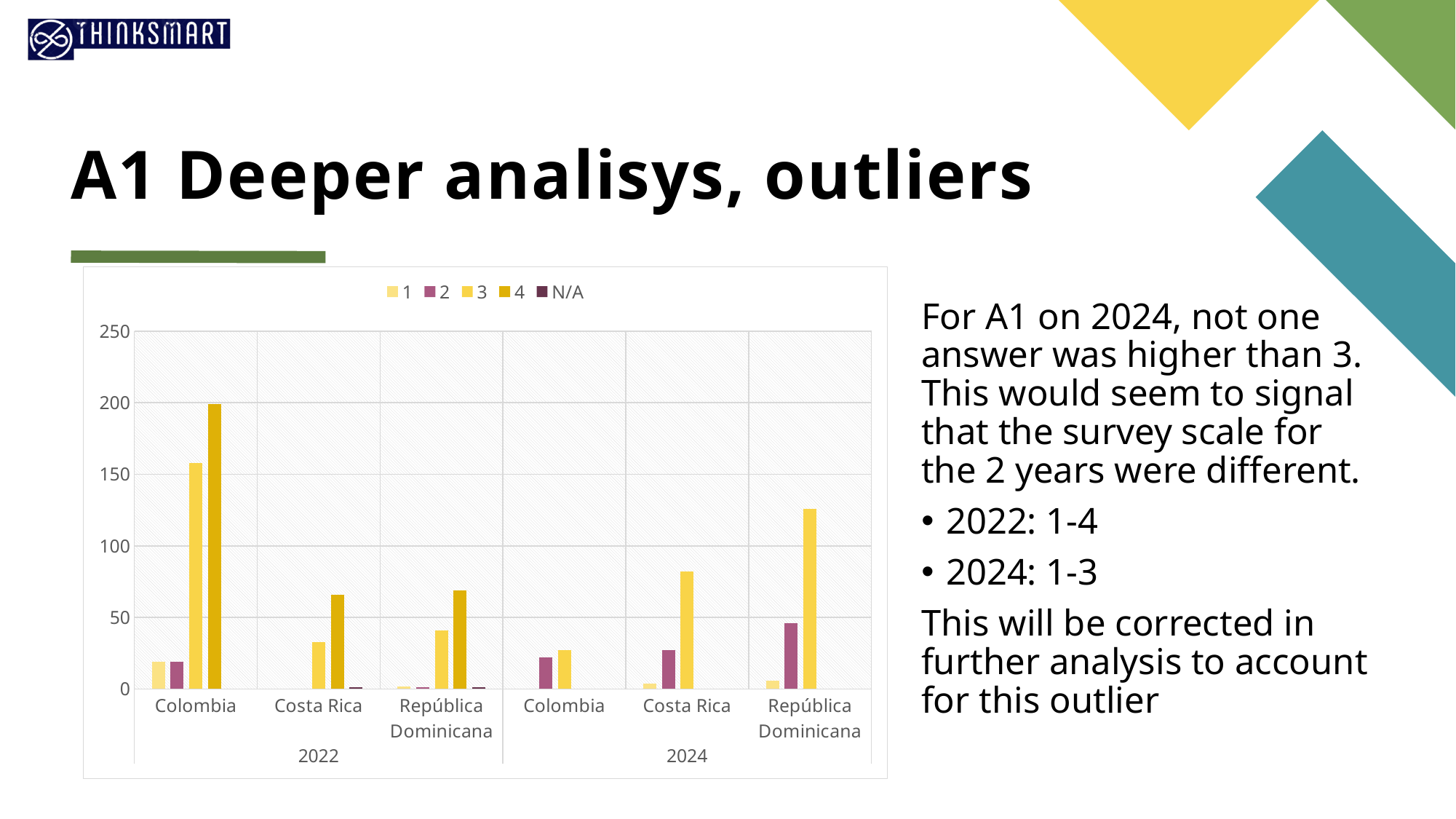
For Colombia in 2022, which is larger: the bar for series 3 or the bar for series 4? 4 Which years are shown on the x axis of the chart? 2022 and 2024 Which series has the tallest bar in the whole chart? 4 Is the value of series 3 for Colombia in 2022 greater or less than 100? greater How many series does the chart legend list? 5 Is the value of series 3 for República Dominicana in 2024 greater or less than 100? greater Is the value of series 4 for Colombia in 2022 greater or less than 150? greater For Colombia in 2022, which series has the tallest bar? 4 What kind of chart is shown on the slide? bar chart How many country categories are plotted under each year in the chart? 3 In 2024, which country has the tallest bar for series 3? República Dominicana